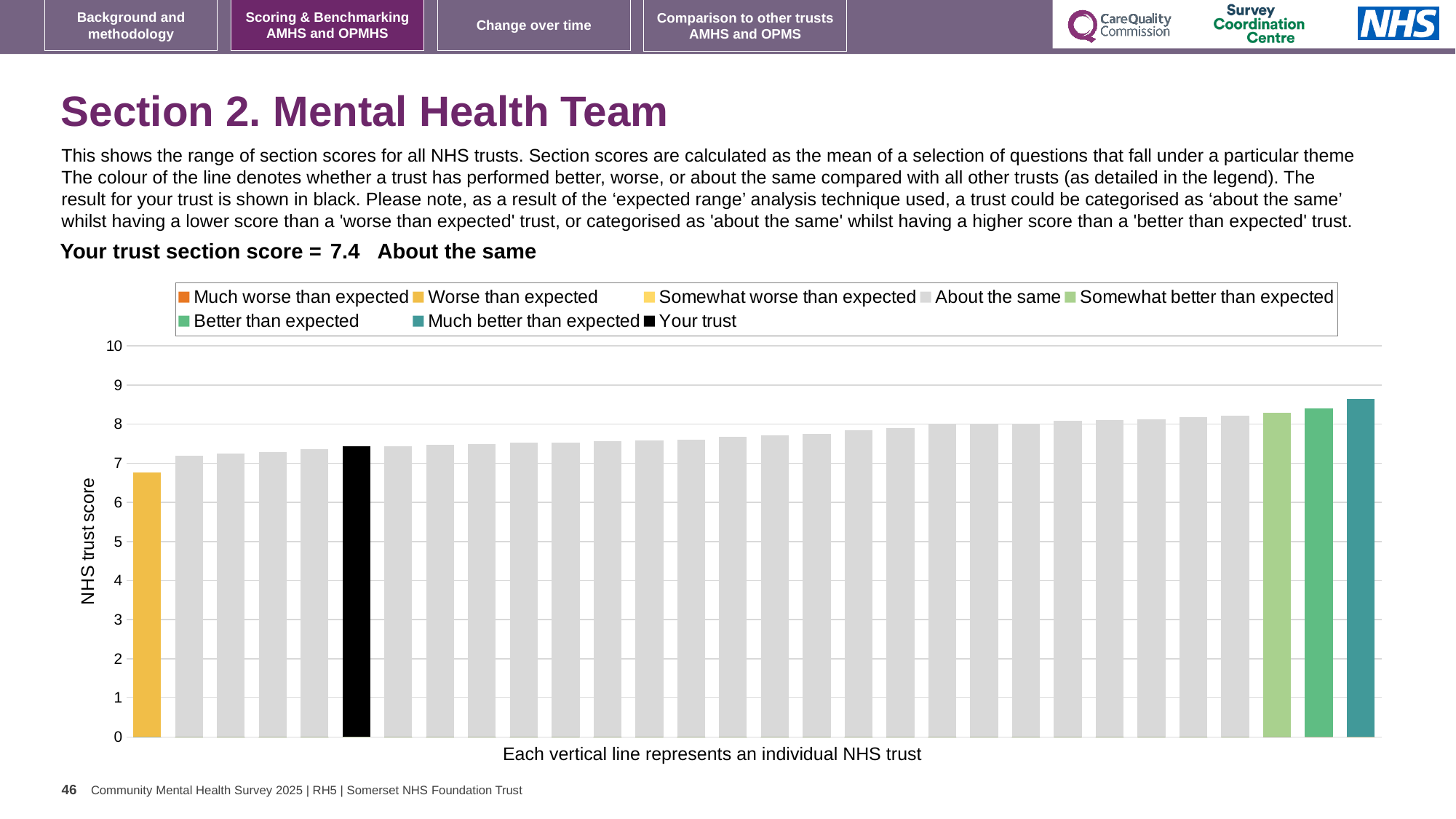
What colour is the bar representing your trust? black Is the value for your trust greater or less than 7? greater Do the bar values rise or fall from left to right along the x axis? rise How many entries does the chart legend list? 8 Which legend category is your trust placed in for this section? About the same Is the value of the rightmost (highest) bar greater or less than 8? greater Which legend category does the lowest bar belong to? Worse than expected What kind of chart is shown on the slide? bar chart Is the value of the rightmost (highest) bar greater or less than 9? less What is the section score for your trust shown on the slide? 7.4 Which legend category does the highest bar belong to? Much better than expected